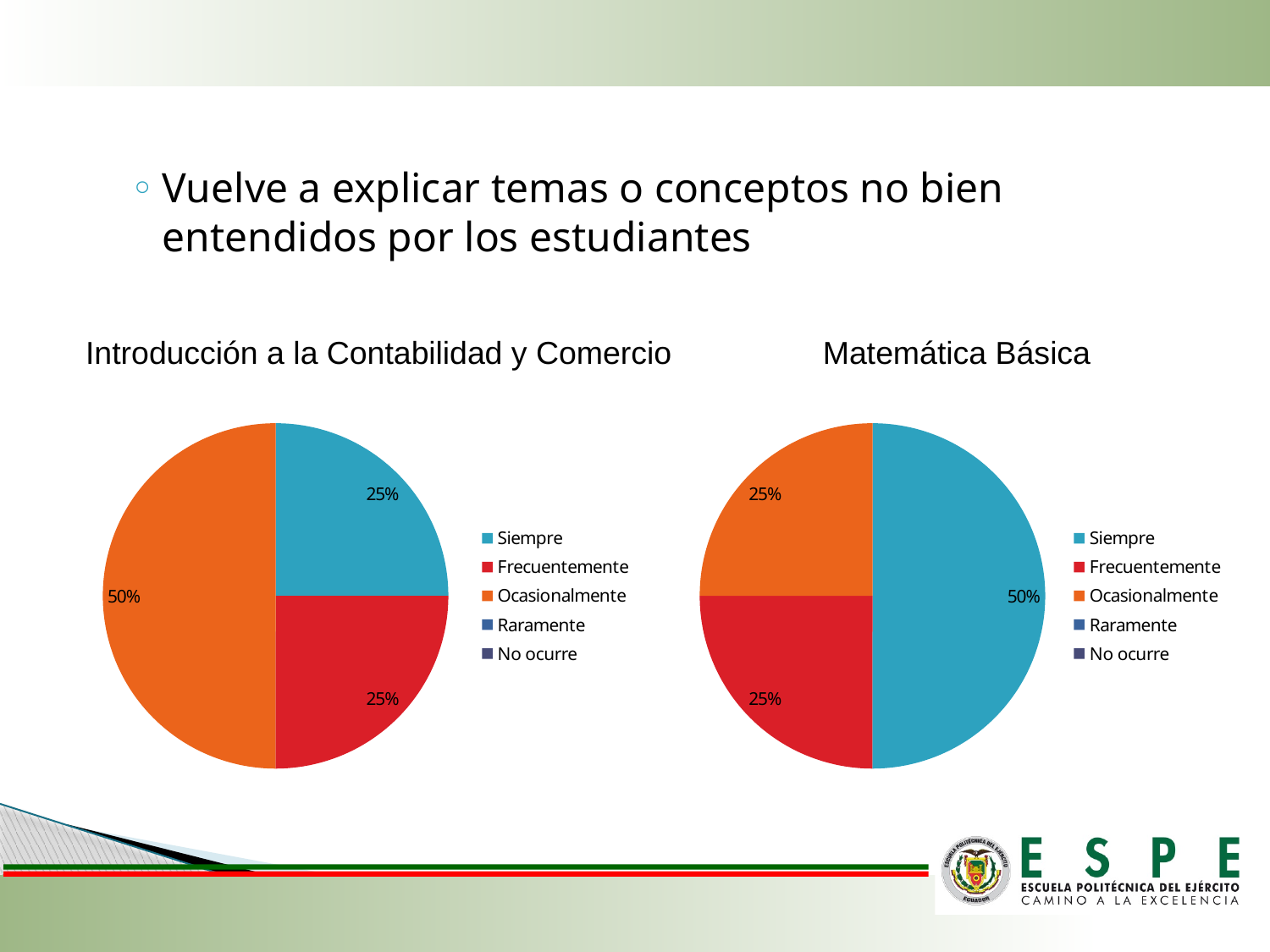
In the 'Introducción a la Contabilidad y Comercio' chart, what is the difference between the Ocasionalmente and Frecuentemente percentages? 25% In the 'Matemática Básica' chart, what share of the pie does Siempre represent? 50% In the 'Introducción a la Contabilidad y Comercio' chart, what percentage is shown for Ocasionalmente? 50% In the 'Matemática Básica' chart, what percentage is shown for Siempre? 50% In the 'Matemática Básica' chart, which is larger, the Siempre slice or the Ocasionalmente slice? Siempre In the 'Matemática Básica' chart, what percentage is shown for Frecuentemente? 25% In the 'Introducción a la Contabilidad y Comercio' chart, which category has the largest slice? Ocasionalmente In the 'Introducción a la Contabilidad y Comercio' chart, what colour is the Ocasionalmente slice? Orange In the 'Introducción a la Contabilidad y Comercio' chart, what percentage is shown for Siempre? 25% How many entries does the legend of the 'Introducción a la Contabilidad y Comercio' chart list? 5 In the 'Matemática Básica' chart, which category has the largest slice? Siempre What type of chart is used for 'Matemática Básica'? Pie chart